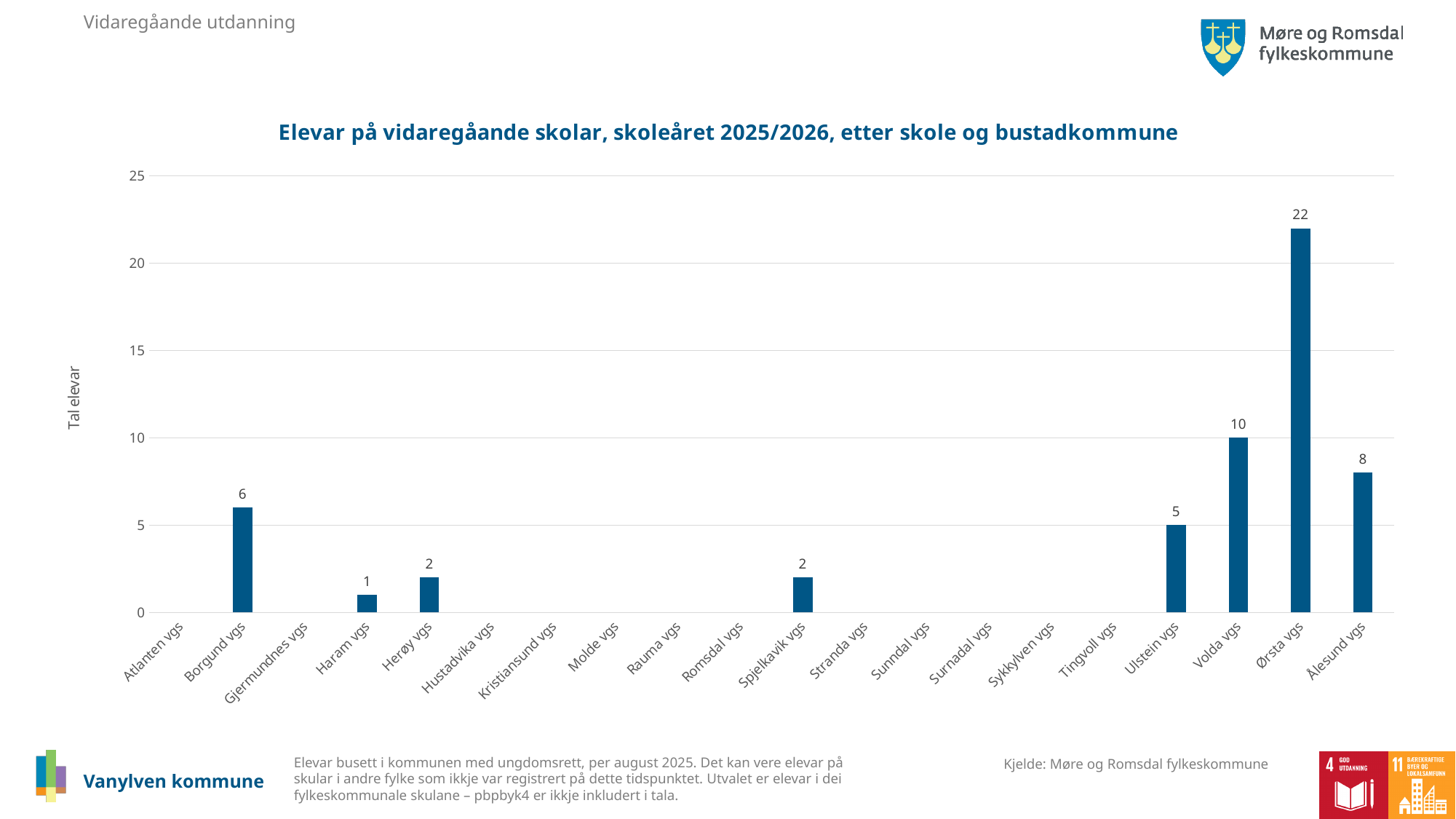
What is the value for Volda vgs? 10 What is the label of the y axis? Tal elevar What kind of chart is shown on the slide? Bar chart Is the value for Ørsta vgs greater or less than 20? greater What is the value for Ulstein vgs? 5 What is the difference between the values for Ørsta vgs and Volda vgs? 12 How many schools are listed on the x axis? 20 How many students are shown for Ørsta vgs? 22 What is the difference between the values for Ålesund vgs and Borgund vgs? 2 Which is larger, the value for Ulstein vgs or the value for Ålesund vgs? Ålesund vgs Which school has the highest number of students? Ørsta vgs What is the value for Borgund vgs? 6